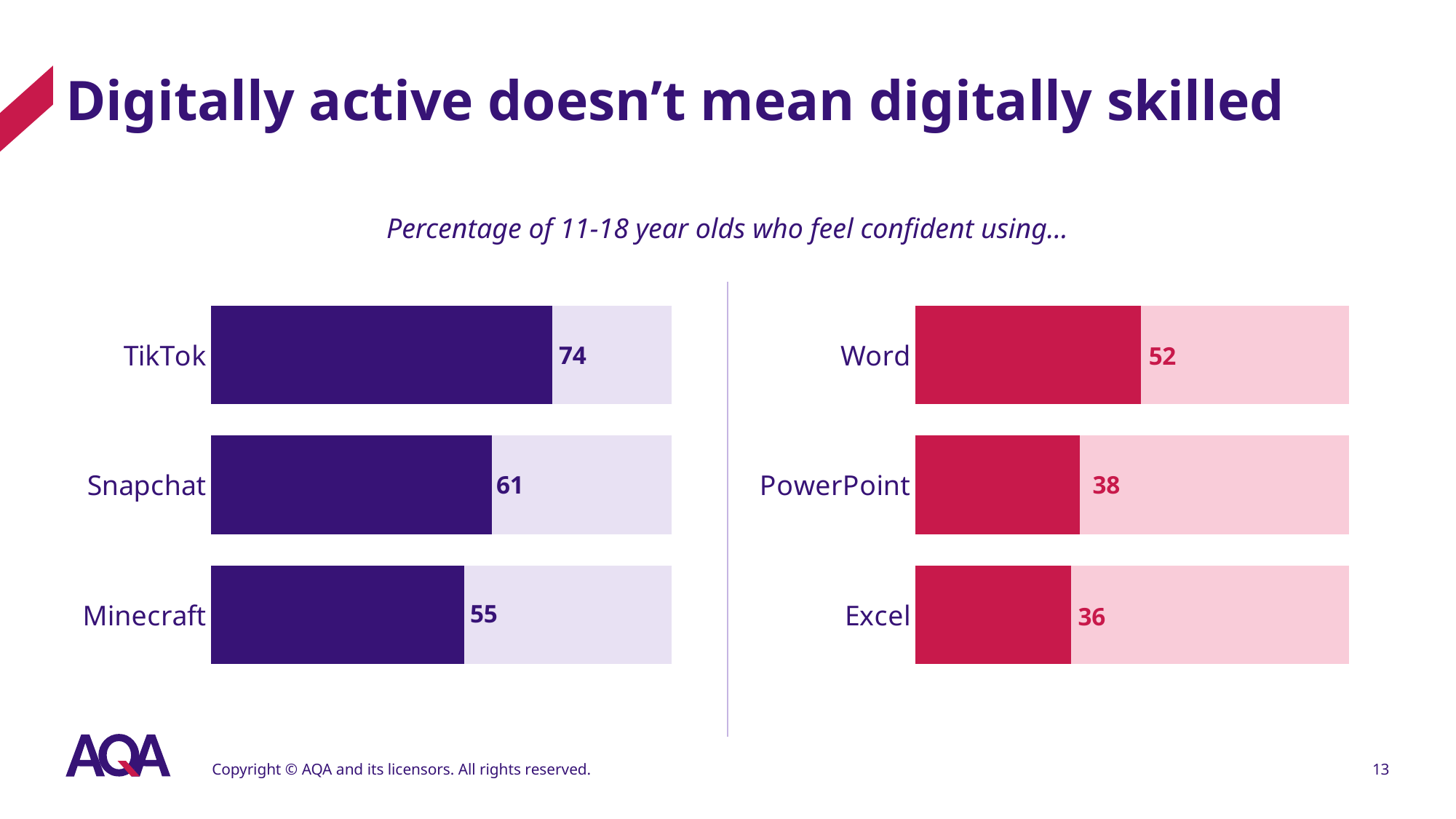
In the right chart, what is the value for PowerPoint? 38 In the left chart, what is the difference between the values for TikTok and Snapchat? 13 In the right chart, which category has the highest value? Word In the left chart, what is the value for Minecraft? 55 What kind of chart is the left chart? Bar chart In the right chart, which category has the lowest value? Excel In the right chart, what is the difference between the values for Word and Excel? 16 What is the subtitle shown above the two charts? Percentage of 11-18 year olds who feel confident using… Which is larger: the value for Snapchat in the left chart or the value for Word in the right chart? Snapchat In the left chart, which category has the lowest value? Minecraft How many categories are shown in the right chart? 3 In the left chart, what is the value for TikTok? 74